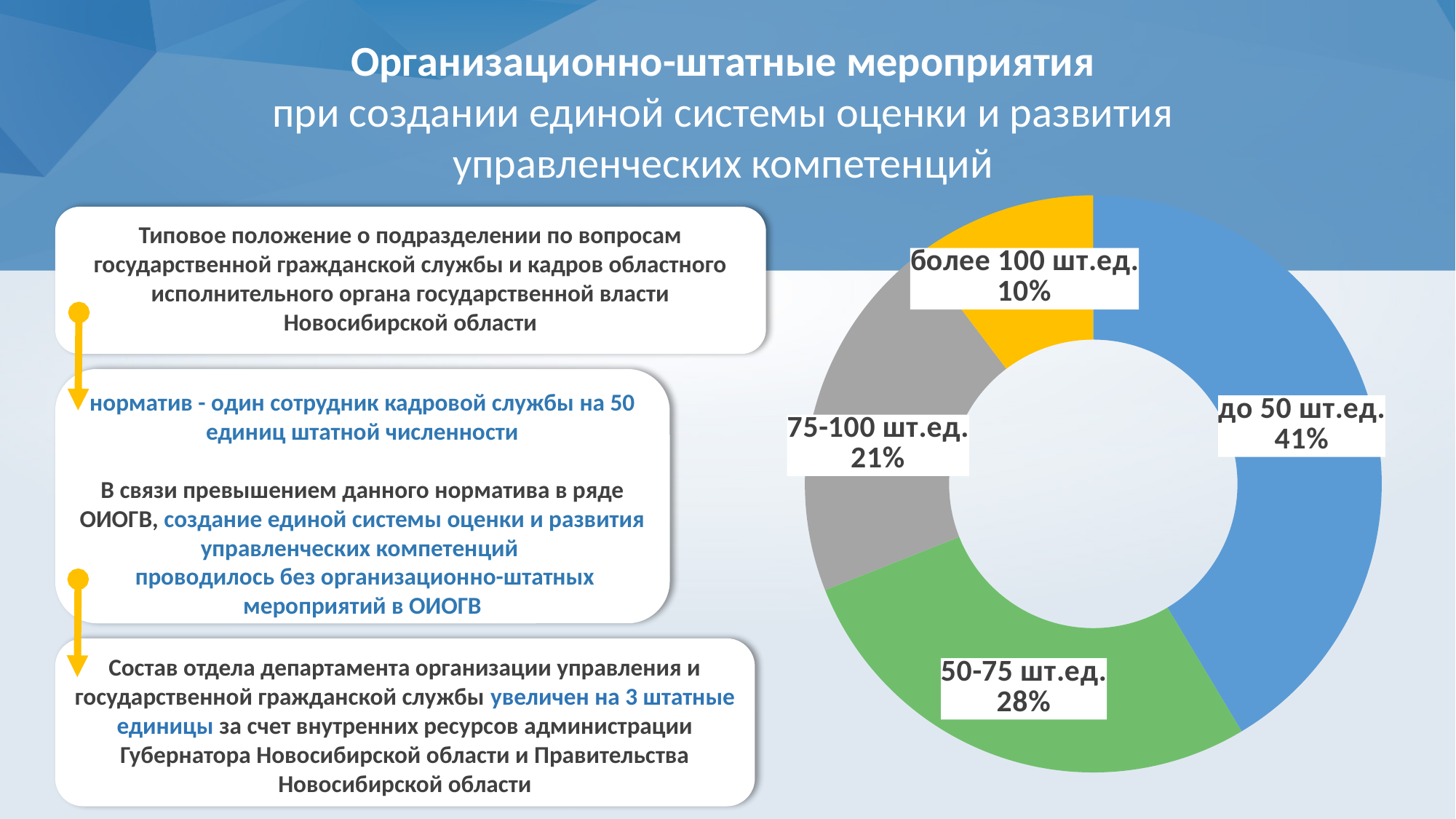
What share of the doughnut chart does the 'до 50 шт.ед.' slice represent? 41% How many categories are shown in the doughnut chart? 4 What colour is the 'до 50 шт.ед.' slice in the doughnut chart? Blue What share of the doughnut chart does the '50-75 шт.ед.' slice represent? 28% What is the difference in percentage points between the '75-100 шт.ед.' slice and the 'более 100 шт.ед.' slice? 11 What type of chart is shown on the slide? Doughnut chart What is the difference in percentage points between the 'до 50 шт.ед.' slice and the '50-75 шт.ед.' slice? 13 What share of the doughnut chart does the '75-100 шт.ед.' slice represent? 21% Which category has the largest slice in the doughnut chart? до 50 шт.ед. What share of the doughnut chart does the 'более 100 шт.ед.' slice represent? 10% Which slice is larger: '50-75 шт.ед.' or '75-100 шт.ед.'? 50-75 шт.ед. Which category has the smallest slice in the doughnut chart? более 100 шт.ед.